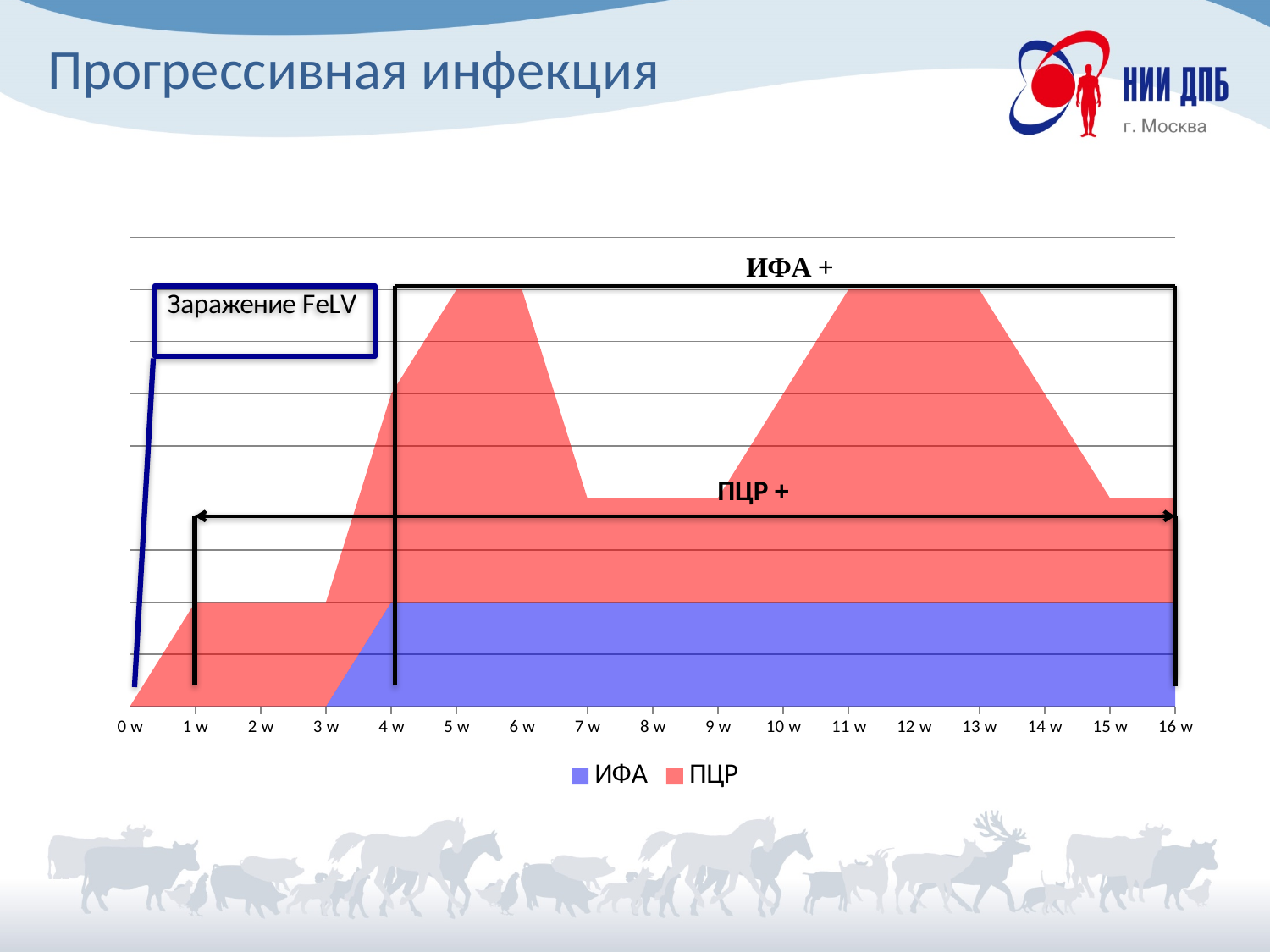
Which series is drawn in red? ПЦР What kind of chart is shown on the slide? area chart How many week labels are shown along the x axis? 17 Does the ИФА series rise or fall between 3 w and 4 w? rise How many series does the legend list? 2 At 1 w, which series has the larger value, ИФА or ПЦР? ПЦР At 5 w, which series has the larger value, ИФА or ПЦР? ПЦР Does the ПЦР series rise or fall between 9 w and 11 w? rise Does the ПЦР series rise or fall between 6 w and 7 w? fall What is the last label on the x axis? 16 w What are the two series named in the legend? ИФА and ПЦР